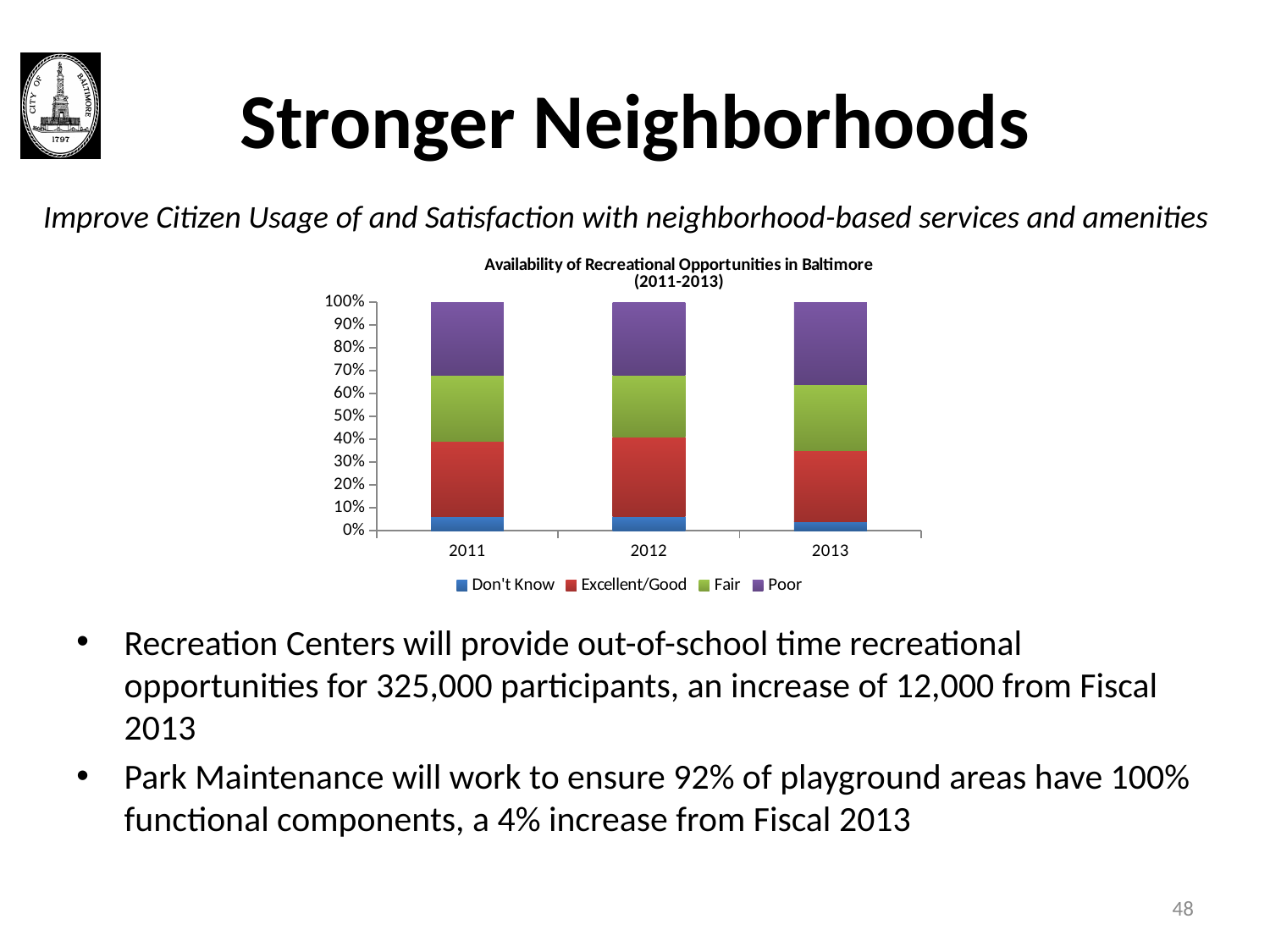
Which series is shown in purple in the chart? Poor Which year has the larger Excellent/Good share, 2012 or 2013? 2012 What does each stacked bar in the chart total? 100% Which year has the larger Poor share, 2011 or 2013? 2013 How many series does the chart legend list? 4 Is the Poor share for 2013 greater or less than 30%? greater What kind of chart is shown on the slide? Stacked bar chart Is the Fair share for 2011 greater or less than 40%? less Is the Don't Know share for 2011 greater or less than 10%? less How many years (bars) are shown on the x axis of the chart? 3 What is the title of the chart? Availability of Recreational Opportunities in Baltimore (2011-2013)